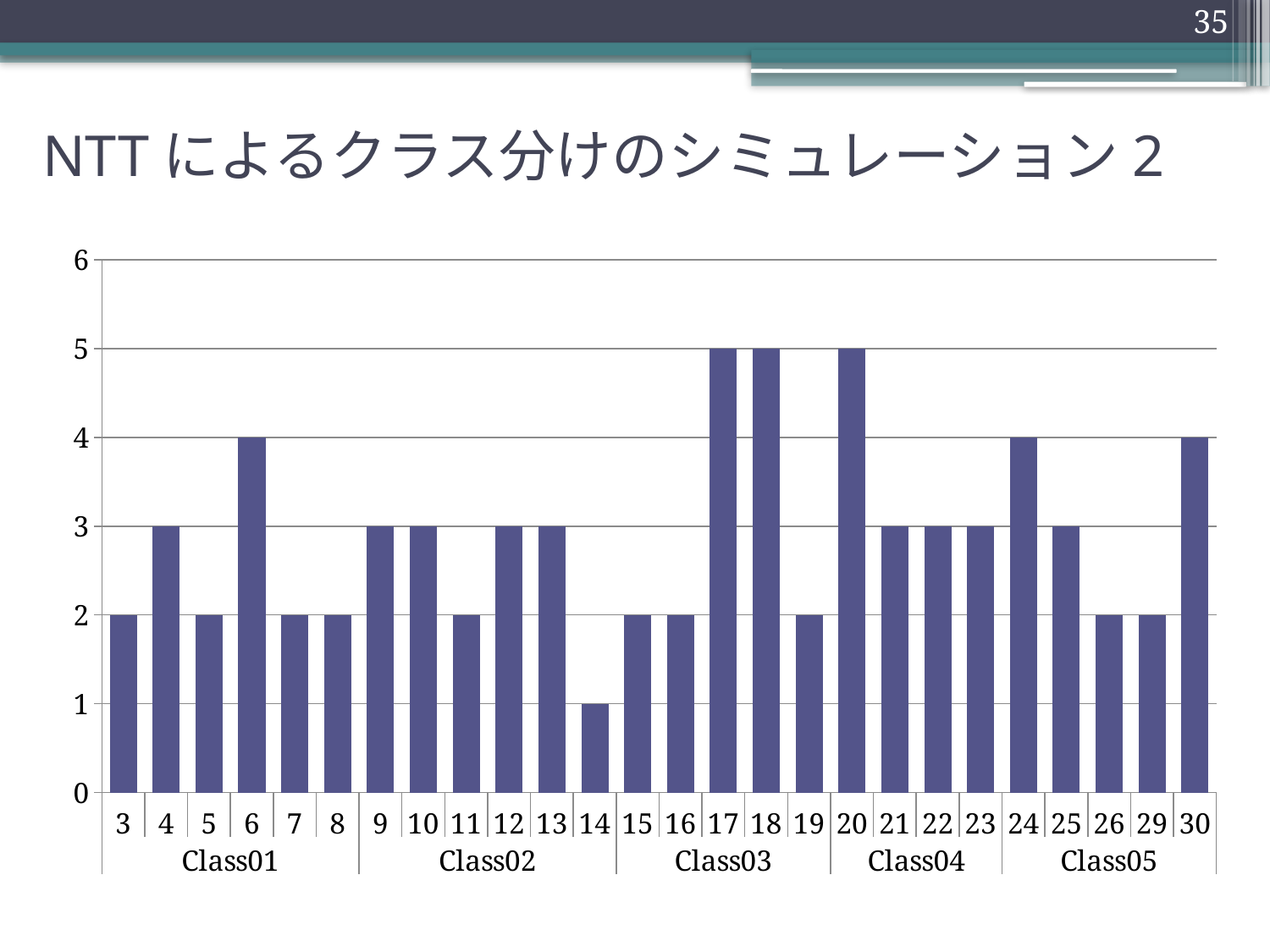
What is the maximum value shown on the y axis? 6 What is the value for category 20? 5 Which category has the lowest bar? 14 What is the highest value reached by any bar? 5 What is the value for category 14? 1 How many class groups are shown along the x axis? 5 What is the difference between the values for category 17 and category 19? 3 What is the value for category 6 in the Class01 group? 4 What is the value for category 30? 4 How many bars are plotted in the chart? 26 Which is larger, the value for category 24 or the value for category 25? 24 What kind of chart is shown on the slide? bar chart